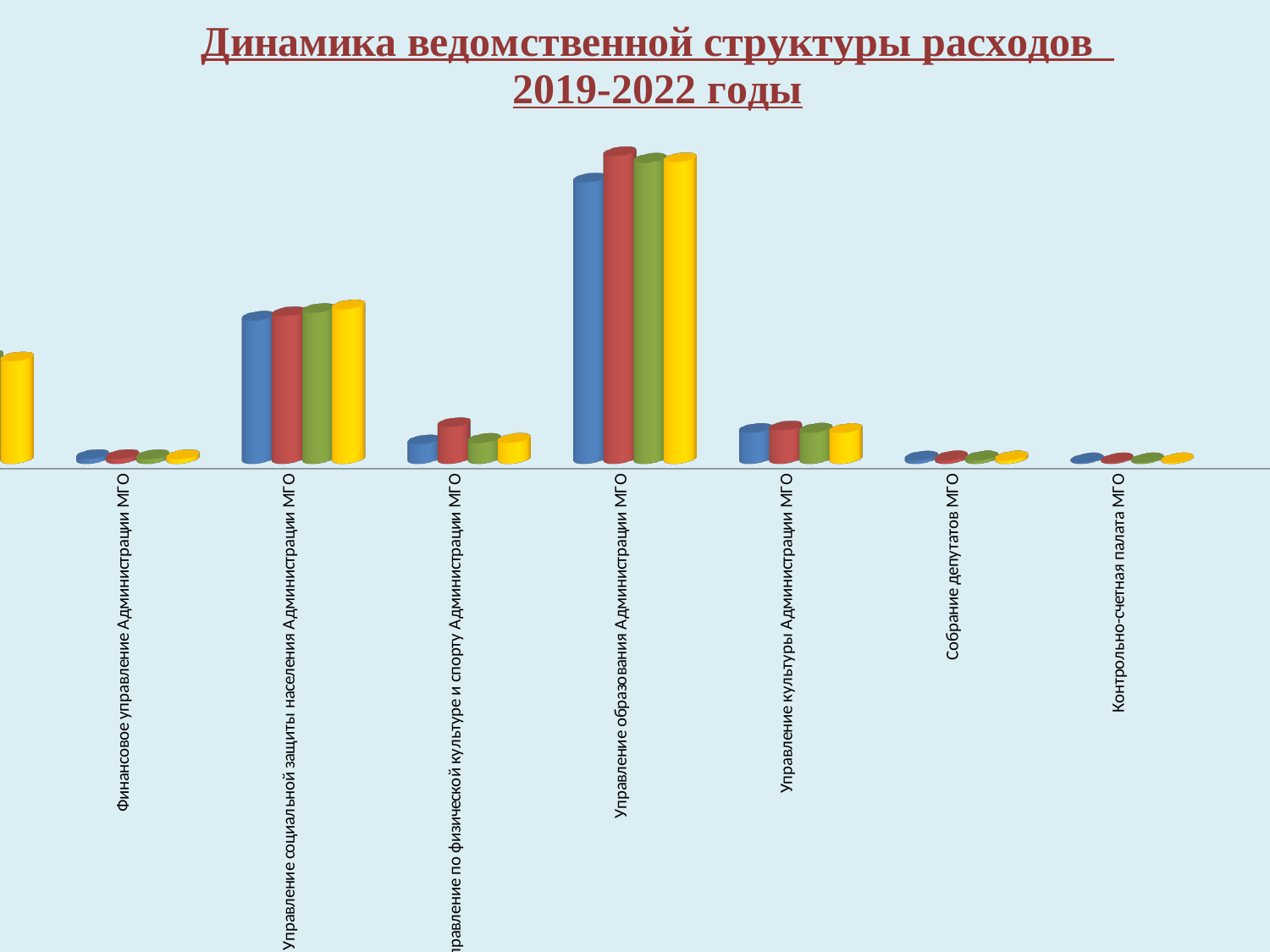
Which category has the tallest bars in the chart? Управление образования Администрации МГО Which has taller bars: Финансовое управление Администрации МГО or Управление по физической культуре и спорту Администрации МГО? Управление по физической культуре и спорту Администрации МГО What colours are the bars in each category group, from left to right? Blue, red, green, yellow Which category has the second-tallest group of bars in the chart? Управление социальной защиты населения Администрации МГО For Управление по физической культуре и спорту Администрации МГО, which coloured bar is the tallest? The red bar For Управление образования Администрации МГО, which is taller: the first (blue) bar or the second (red) bar? The second (red) bar How many bars are plotted for each category in the chart? 4 Which has taller bars: Управление образования Администрации МГО or Управление культуры Администрации МГО? Управление образования Администрации МГО What is the title of the chart on the slide? Динамика ведомственной структуры расходов 2019-2022 годы What kind of chart is shown on the slide? Bar chart